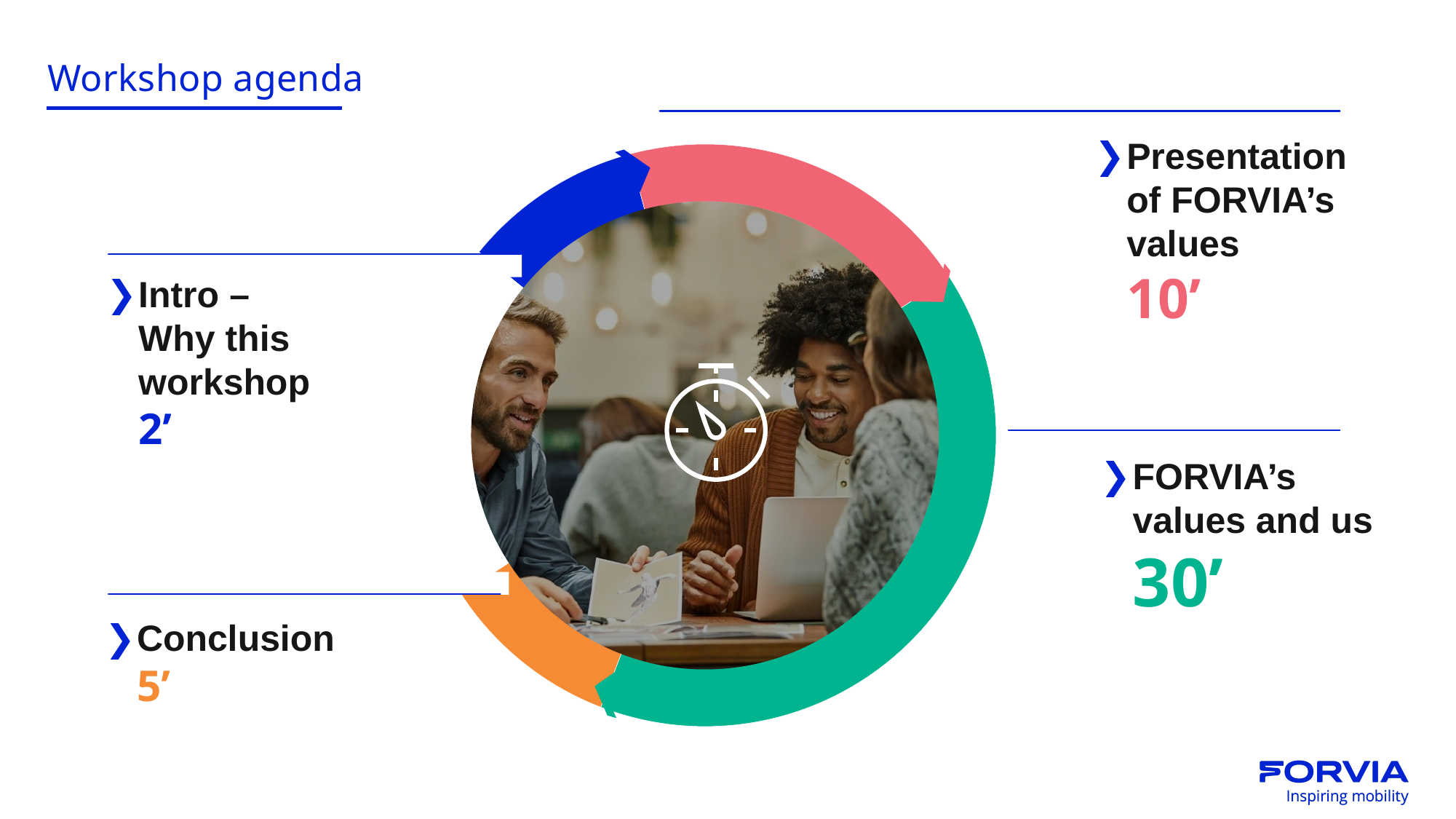
How many minutes are allocated to the "Conclusion" segment? 5' How many minutes are allocated to "FORVIA's values and us"? 30' What is the title of the slide? Workshop agenda How many minutes are allocated to "Presentation of FORVIA's values"? 10' Which agenda segment has the shortest duration? Intro – Why this workshop What colour is the segment for "FORVIA's values and us"? Green Which is longer, the "Conclusion" or the "Intro – Why this workshop" segment? Conclusion Which agenda segment has the longest duration? FORVIA's values and us How many minutes are allocated to the "Intro – Why this workshop" segment? 2' What is the difference in minutes between "FORVIA's values and us" and "Presentation of FORVIA's values"? 20' How many agenda segments are shown in the circular diagram? 4 What is the total duration of all four agenda segments? 47'